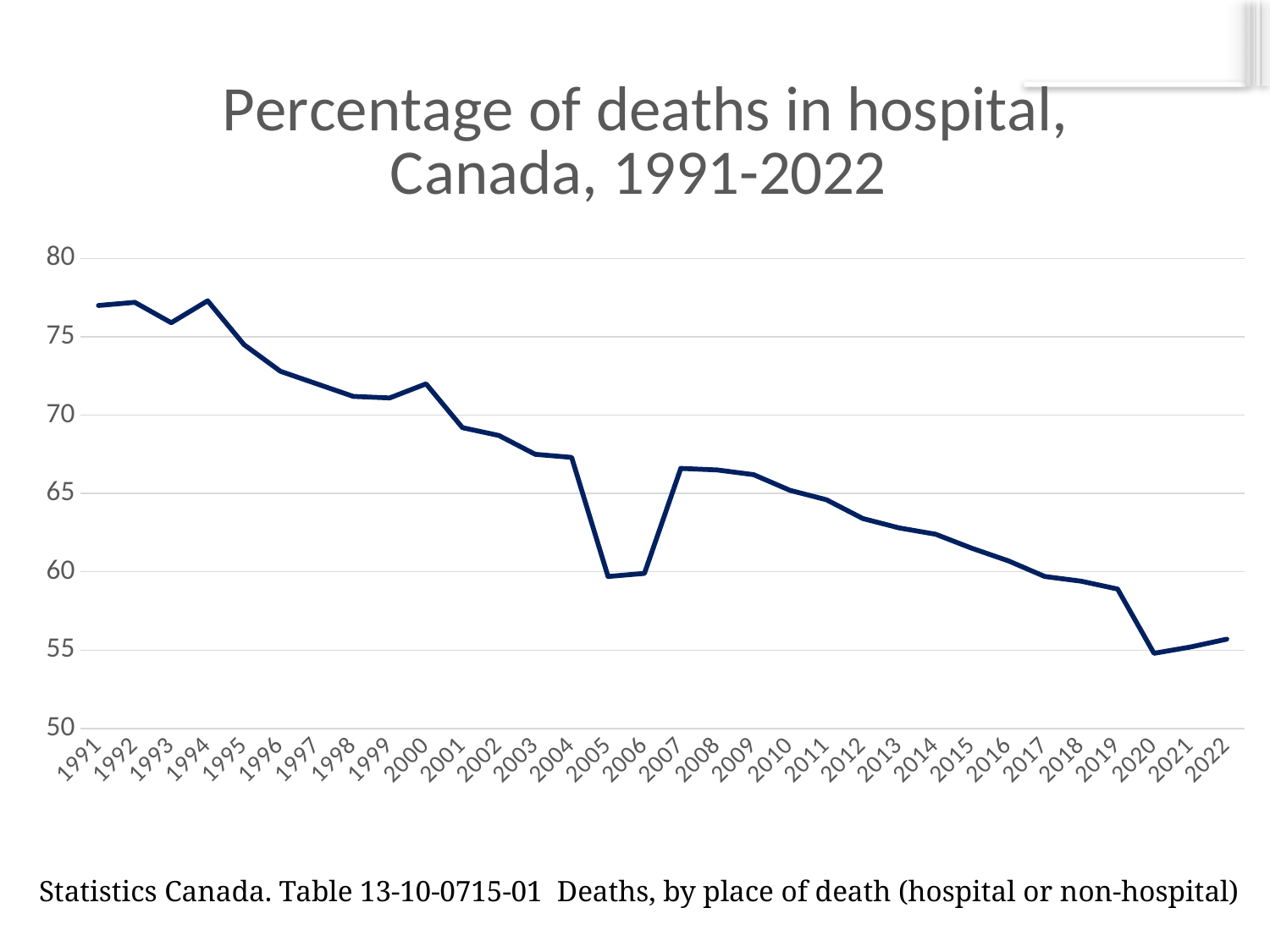
Is the value for 2000 greater or less than 70? greater What kind of chart is shown on the slide? line chart Overall, do the values rise or fall from 1991 to 2022? fall Is the value for 2013 greater or less than 65? less Which year has the higher value, 1991 or 2022? 1991 How many years are plotted along the x axis? 32 Which year has the lowest percentage of deaths in hospital? 2020 Is the value for 1991 greater or less than 75? greater What is the title of the chart? Percentage of deaths in hospital, Canada, 1991-2022 Which year has the higher value, 2005 or 2007? 2007